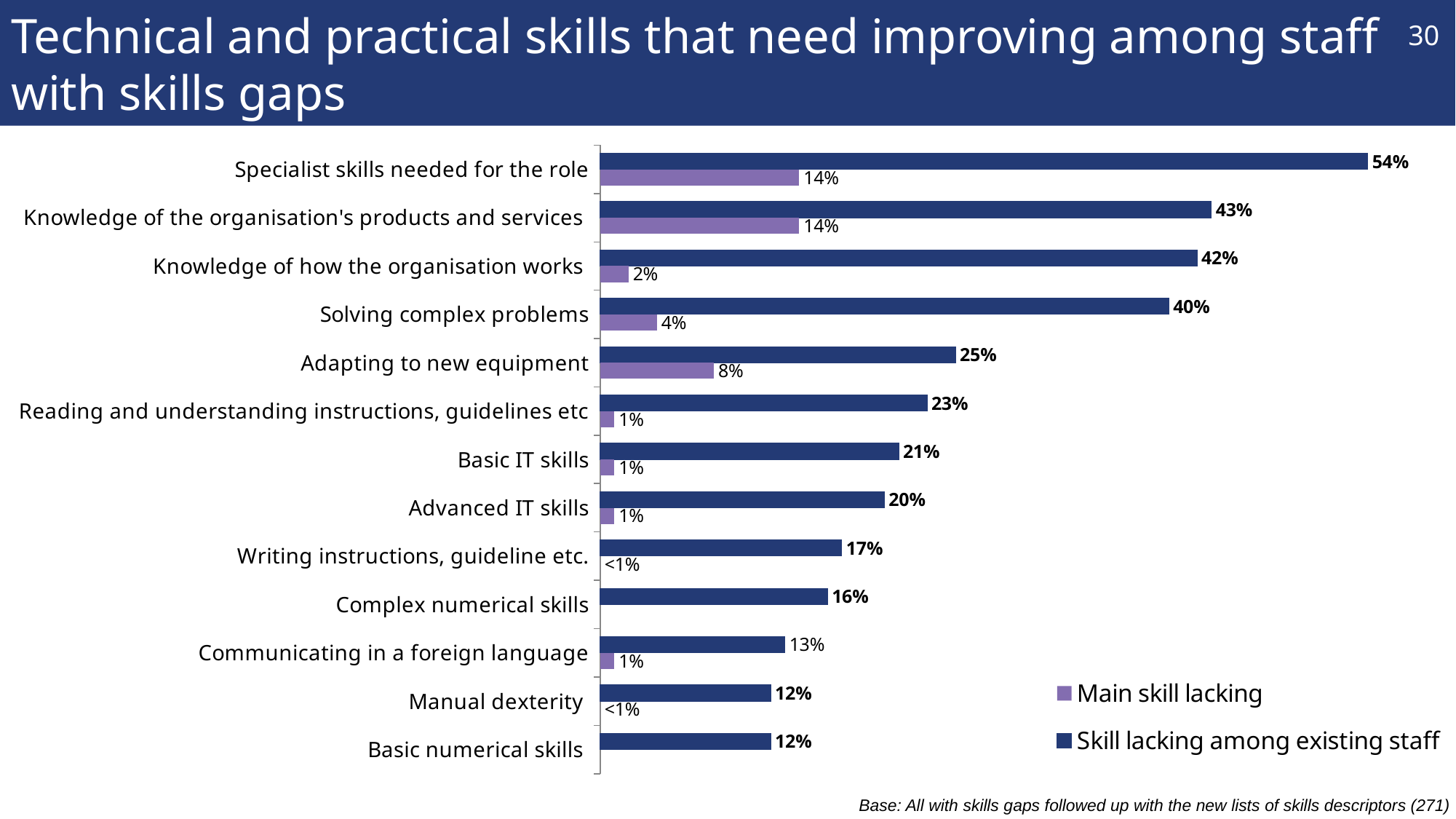
What is the 'Skill lacking among existing staff' value for Communicating in a foreign language? 13% How many skill categories are listed on the chart? 13 What is the difference in percentage points between the 'Skill lacking among existing staff' values for Specialist skills needed for the role and Knowledge of the organisation's products and services? 11 percentage points What kind of chart is shown on the slide? Bar chart Which category has the highest 'Skill lacking among existing staff' value? Specialist skills needed for the role What percentage is shown for 'Skill lacking among existing staff' for Specialist skills needed for the role? 54% How many series does the legend list? 2 What is the 'Main skill lacking' value for Adapting to new equipment? 8% What is the 'Main skill lacking' value for Knowledge of how the organisation works? 2% Which has a larger 'Skill lacking among existing staff' value: Basic IT skills or Advanced IT skills? Basic IT skills Which has a larger 'Main skill lacking' value: Solving complex problems or Adapting to new equipment? Adapting to new equipment Which series is shown in purple according to the legend? Main skill lacking